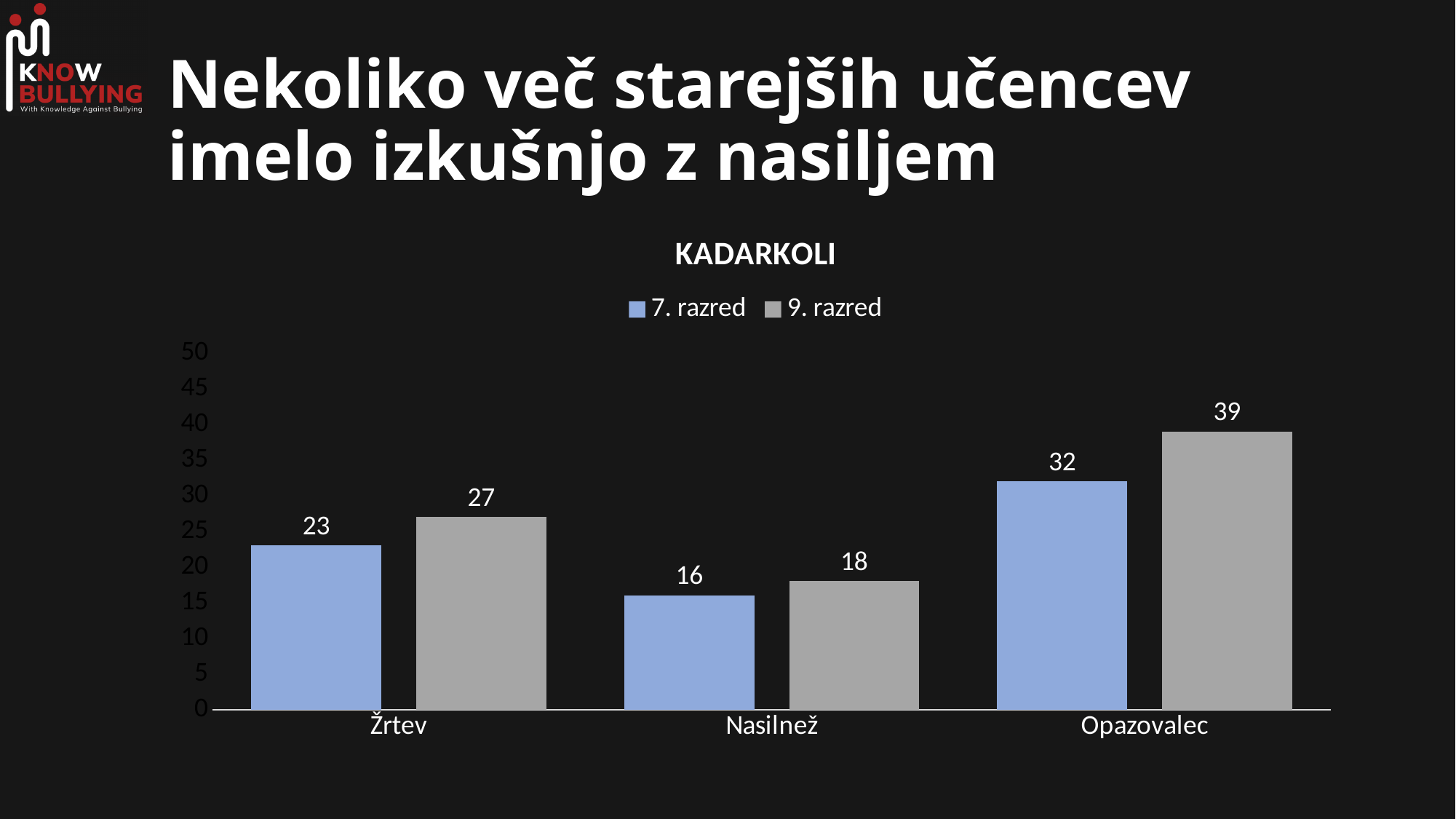
How many series does the legend list? 2 What is the difference between the 9. razred and 7. razred values for Opazovalec? 7 What is the value for 9. razred in the Nasilnež category? 18 Which category has the highest value for 9. razred? Opazovalec What is the title of the chart? KADARKOLI What is the value for 7. razred in the Žrtev category? 23 What kind of chart is shown on the slide? Bar chart What is the difference between the 9. razred and 7. razred values for Žrtev? 4 What is the value for 9. razred in the Opazovalec category? 39 Which category has the lowest value for 7. razred? Nasilnež How many categories are shown on the x axis? 3 Which is larger for Nasilnež: the 7. razred value or the 9. razred value? 9. razred